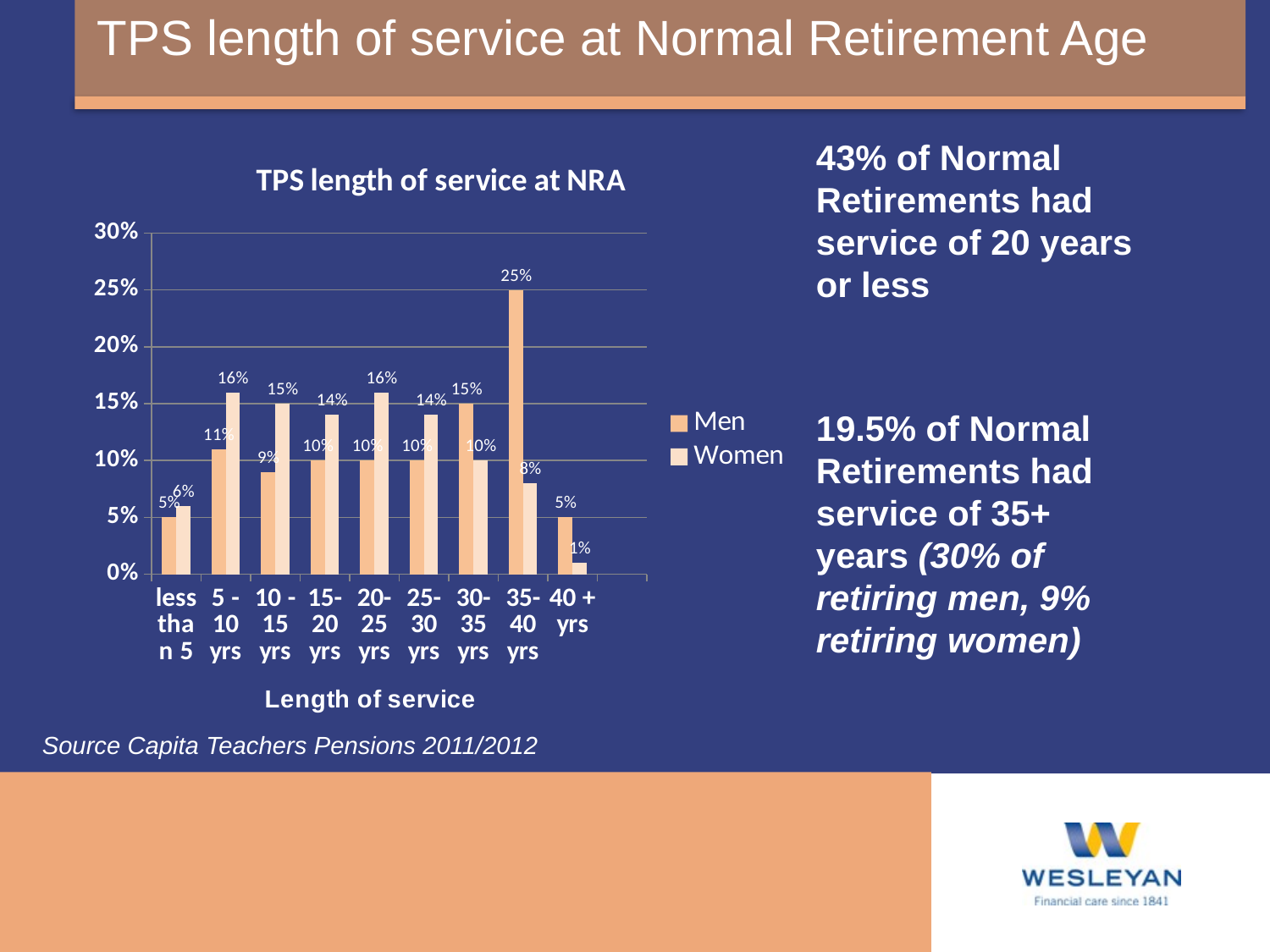
What is the value for Women in the 5 - 10 yrs category? 16% How many length-of-service categories are shown on the x axis? 9 Which length-of-service category has the lowest value for Women? 40 + yrs What is the title of the chart? TPS length of service at NRA How many series does the chart legend list? 2 Which length-of-service category has the highest value for Men? 35-40 yrs What is the value for Women in the 40 + yrs category? 1% In the 10 - 15 yrs category, which is larger, the Men value or the Women value? Women What is the difference between the Men and Women values in the 35-40 yrs category? 17% What type of chart is shown on the slide? bar chart What is the value for Men in the 35-40 yrs category? 25% Is the value for Men in the 35-40 yrs category greater or less than 20%? greater